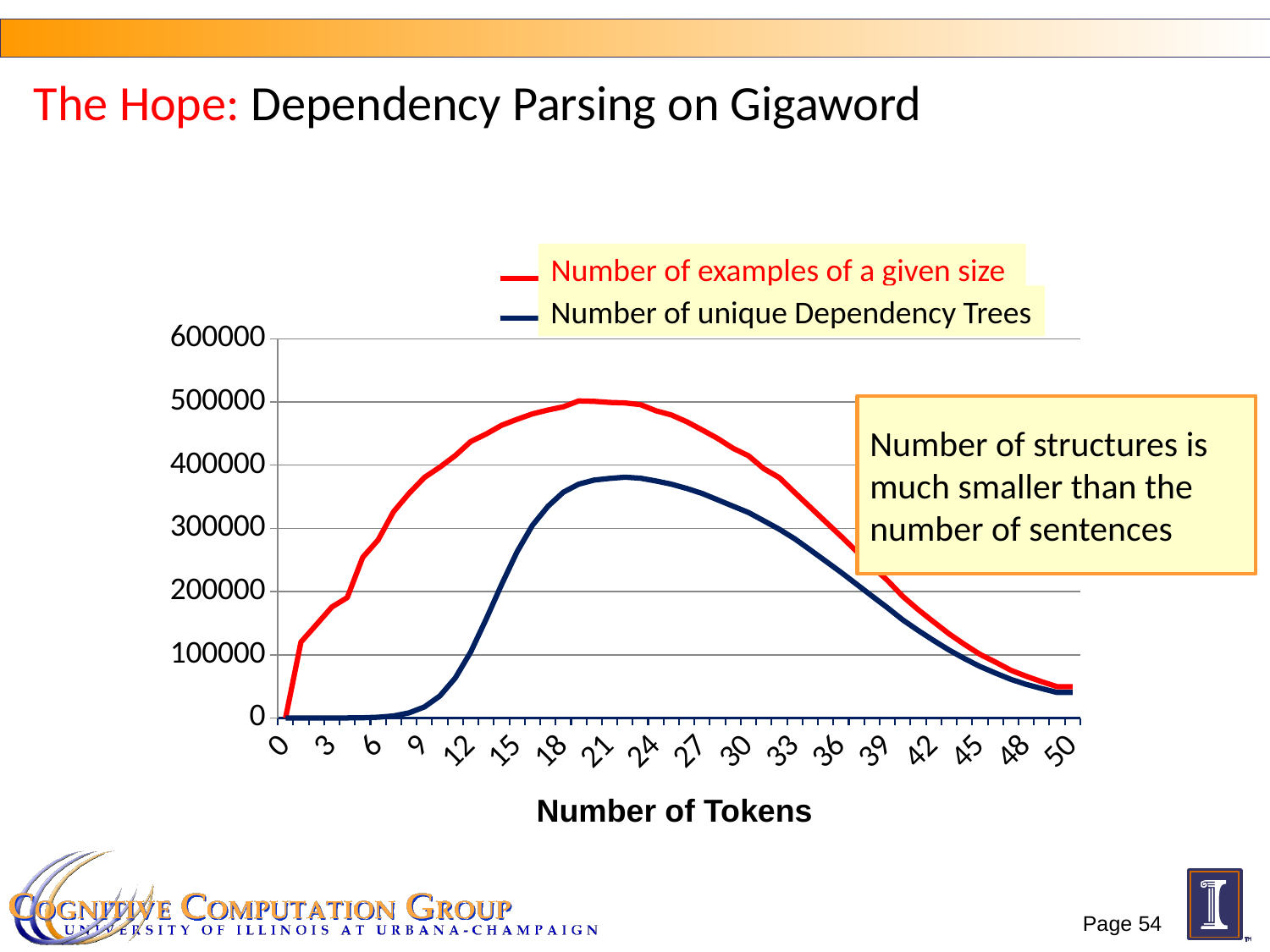
Between 24 and 50 tokens, does the 'Number of examples of a given size' line rise or fall? fall Is the value of 'Number of examples of a given size' at 50 tokens greater or less than 100000? less Which series is drawn in red according to the legend? Number of examples of a given size Which series reaches the higher peak value? Number of examples of a given size Is the value of 'Number of unique Dependency Trees' at 9 tokens greater or less than 100000? less What is the title of the x axis? Number of Tokens At 15 tokens, which series has the larger value: 'Number of examples of a given size' or 'Number of unique Dependency Trees'? Number of examples of a given size How many series does the legend list? 2 Is the value of 'Number of unique Dependency Trees' at 21 tokens greater or less than 400000? less What kind of chart is shown on the slide? line chart